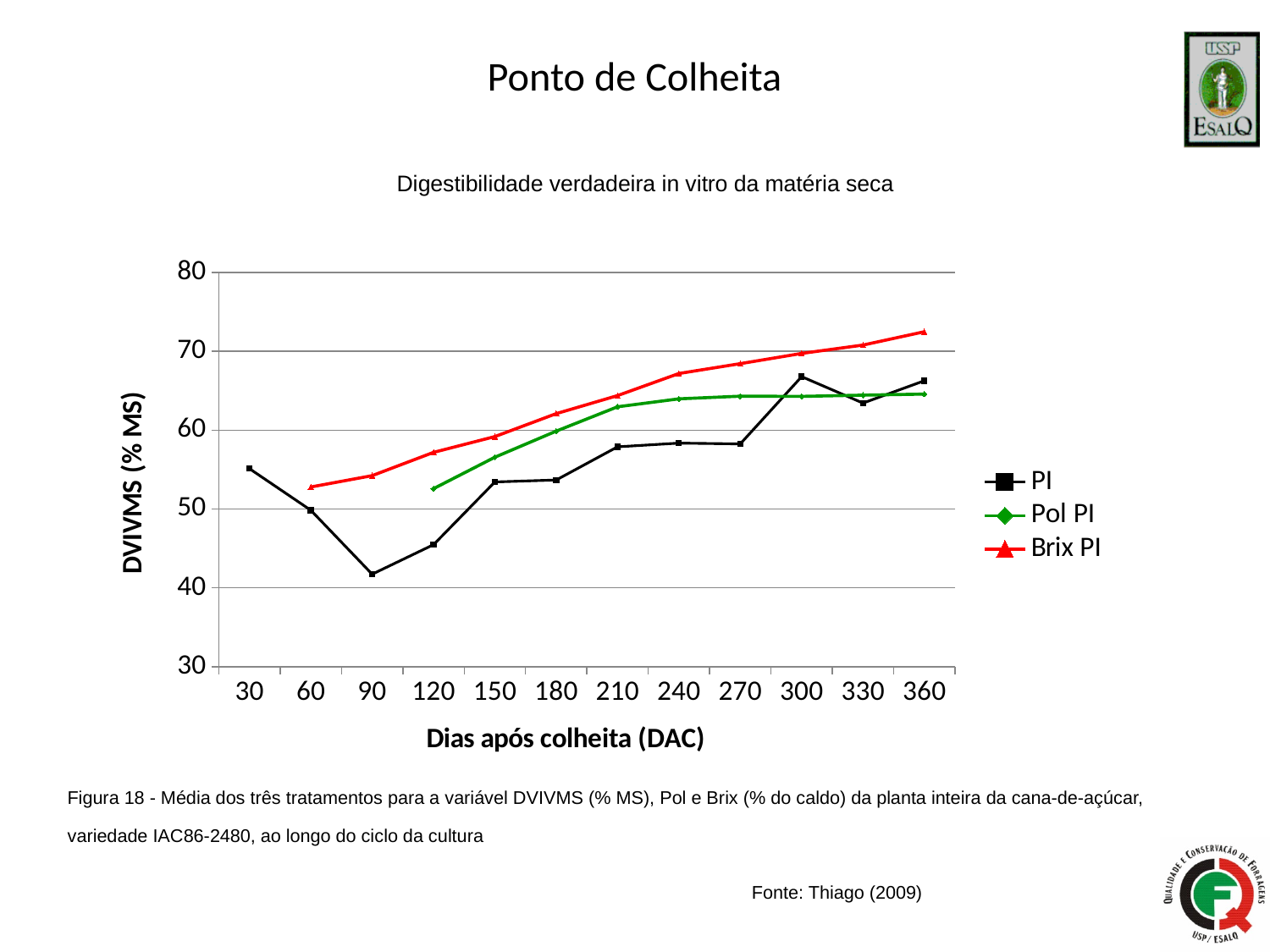
At which DAC value does the Brix PI series reach its highest point? 360 Is the value of PI at 90 DAC greater or less than 50? less At 360 DAC, which is larger: PI or Brix PI? Brix PI At 90 DAC, which is larger: PI or Brix PI? Brix PI How many series does the legend list? 3 At which DAC value does the PI series reach its lowest point? 90 Does the Brix PI series rise or fall along the x axis? rise What kind of chart is shown on the slide? line chart Is the value of Brix PI at 360 DAC greater or less than 70? greater Is the value of PI at 30 DAC greater or less than 50? greater What is the title of the y axis? DVIVMS (% MS) How many points are labelled on the x axis (Dias após colheita)? 12